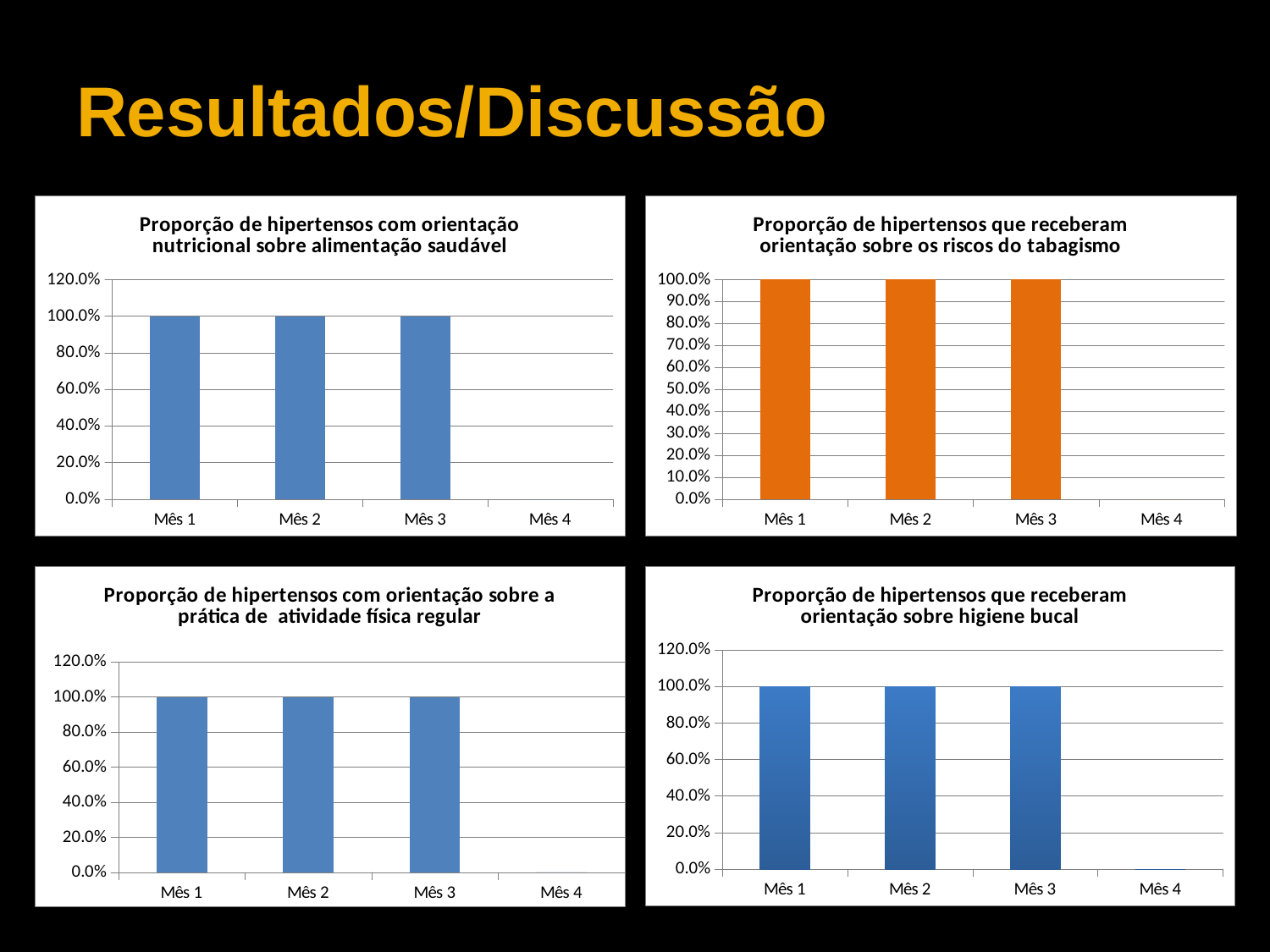
In the top-right chart, what is the highest value shown on the y axis? 100.0% In the bottom-right chart (Proporção de hipertensos que receberam orientação sobre higiene bucal), what is the value for Mês 1? 100.0% In the top-right chart (Proporção de hipertensos que receberam orientação sobre os riscos do tabagismo), what is the value for Mês 3? 100.0% In the bottom-left chart, what is the difference between the values for Mês 1 and Mês 3? 0.0% In the top-left chart (Proporção de hipertensos com orientação nutricional sobre alimentação saudável), what is the value for Mês 1? 100.0% In the bottom-left chart (Proporção de hipertensos com orientação sobre a prática de atividade física regular), what is the value for Mês 2? 100.0% In the top-left chart, how many categories are shown on the x axis? 4 In the top-right chart, what colour are the bars? orange In the bottom-right chart, is the value for Mês 2 greater or less than 80.0%? greater What kind of chart is the top-right chart (Proporção de hipertensos que receberam orientação sobre os riscos do tabagismo)? bar chart How many charts are shown on the slide? 4 In the top-left chart, what is the highest value shown on the y axis? 120.0%